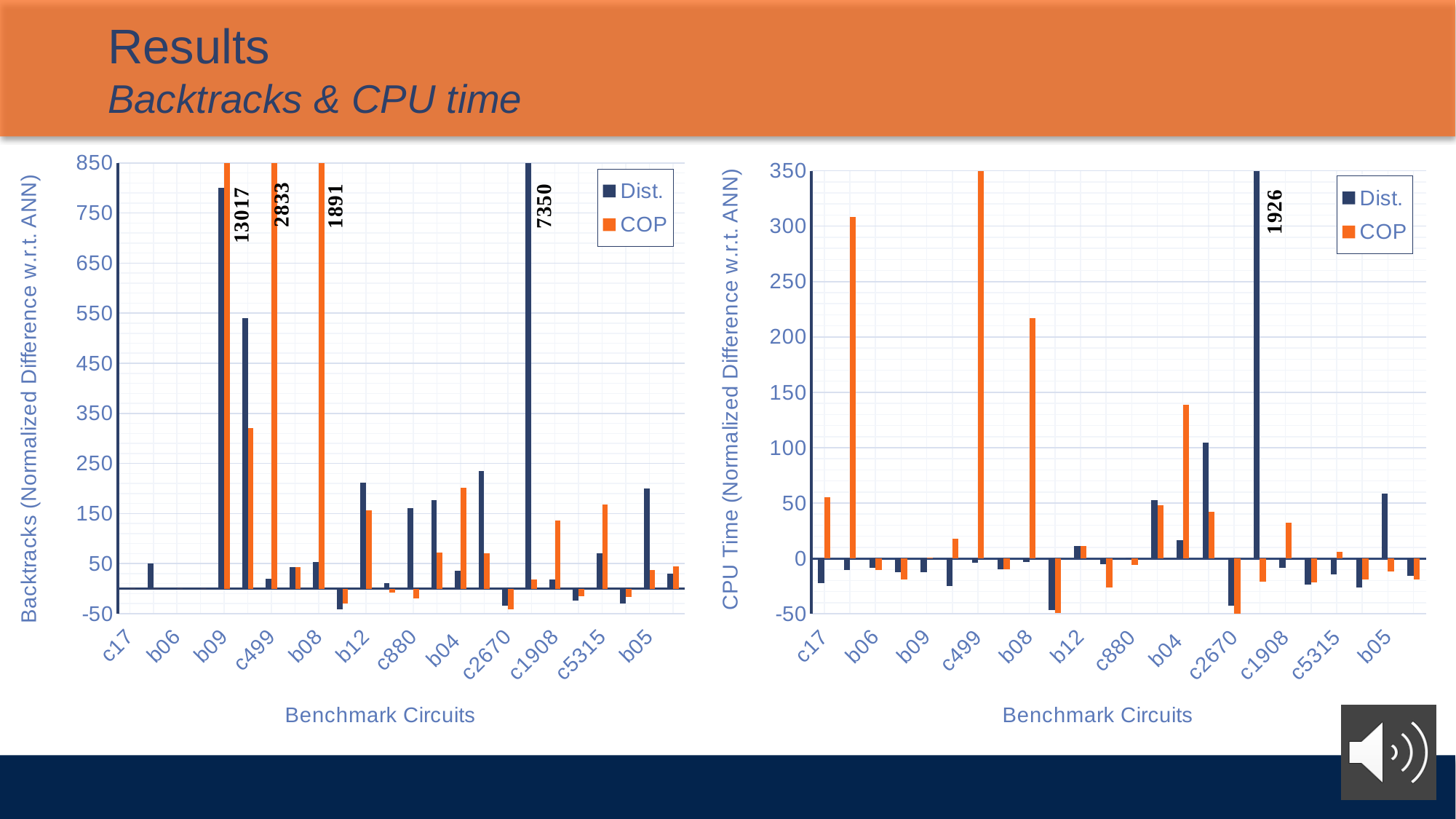
On the Backtracks chart, which series does the bar labeled 7350 belong to? Dist. On the Backtracks chart, what is the difference between the bars labeled 13017 and 7350? 5667 On the Backtracks chart, what is the largest value printed as a data label? 13017 What kind of chart is the Backtracks chart on the left? bar chart On the CPU Time chart, is the COP value for b08 greater or less than 200? greater What are the two series named in the legend of the Backtracks chart? Dist. and COP On the Backtracks chart, which is larger: the bar labeled 2833 or the bar labeled 1891? 2833 How many series does the legend of the CPU Time chart list? 2 What is the y-axis title of the CPU Time chart on the right? CPU Time (Normalized Difference w.r.t. ANN) On the CPU Time chart, what value is printed on the tallest Dist. bar? 1926 On the Backtracks chart, which series does the bar labeled 13017 belong to? COP How many benchmark circuit labels are shown on the x axis of the Backtracks chart? 12